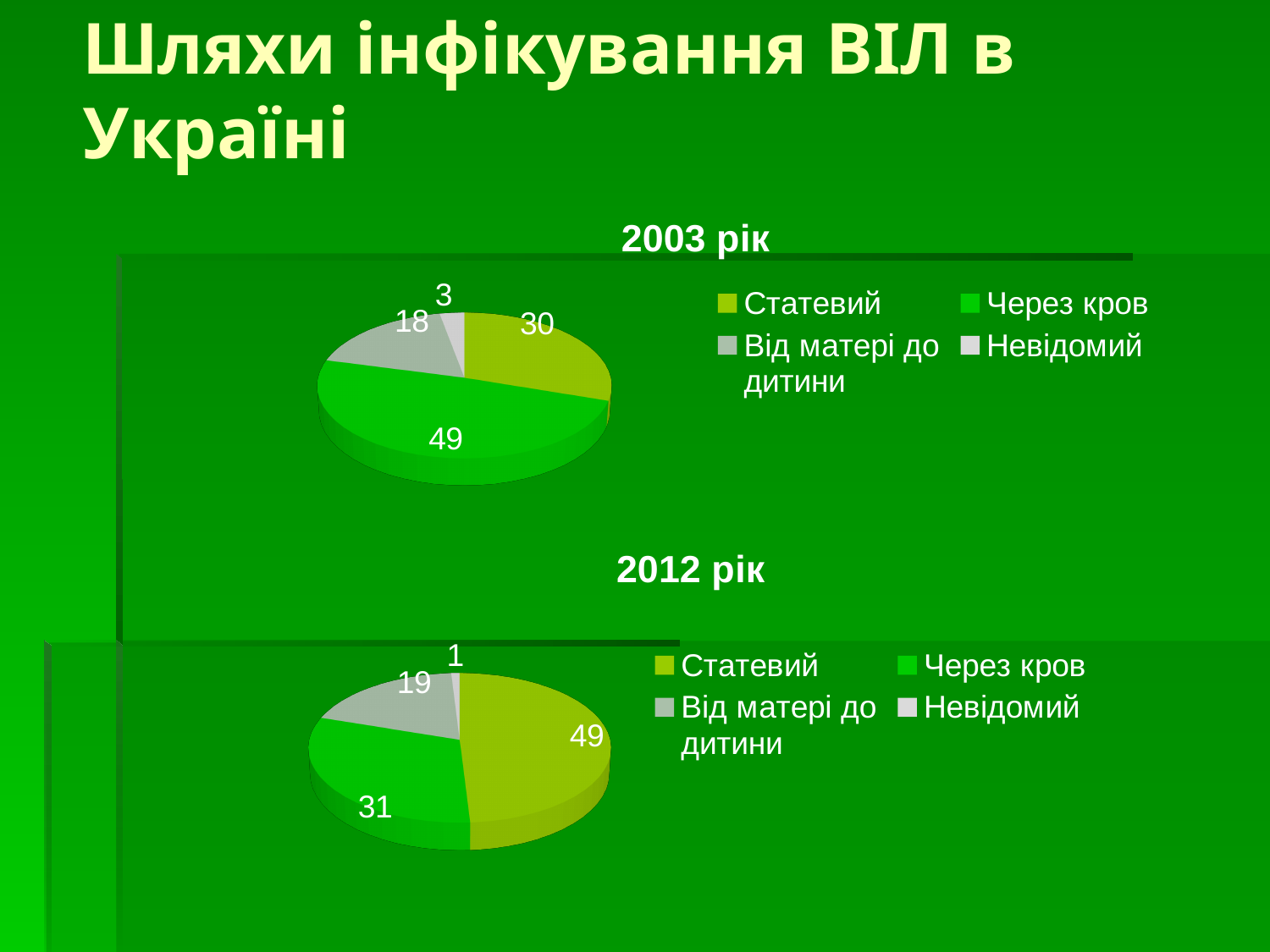
In the "2003 рік" chart, what is the value for Від матері до дитини? 18 In the "2003 рік" chart, what colour is the Статевий slice? Yellow-green In the "2003 рік" chart, what is the difference between the values for Через кров and Статевий? 19 In the "2012 рік" chart, what is the value for Статевий? 49 What type of chart is the "2012 рік" chart? Pie chart In the "2012 рік" chart, which is larger: Через кров or Від матері до дитини? Через кров In the "2012 рік" chart, which category has the smallest slice? Невідомий In the "2003 рік" chart, which category has the largest slice? Через кров In the "2012 рік" chart, what is the difference between the values for Статевий and Через кров? 18 In the "2012 рік" chart, what is the value for Невідомий? 1 In the "2003 рік" chart, what is the value for Через кров? 49 How many categories does the "2003 рік" chart show? 4